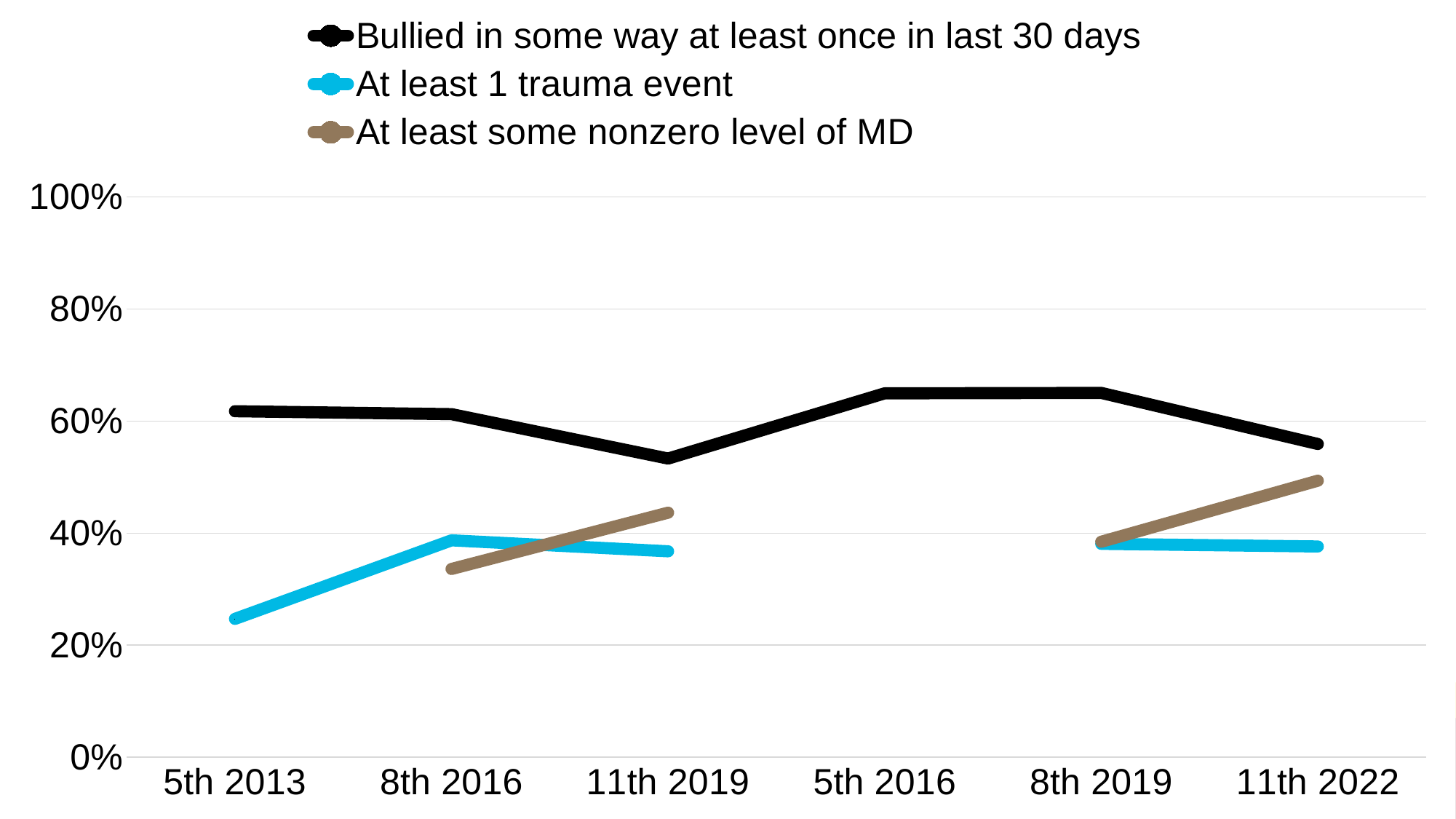
At which category is the 'At least some nonzero level of MD' series highest? 11th 2022 Is the value for 'At least 1 trauma event' at 5th 2013 greater or less than 40%? less How many series does the legend list? 3 What kind of chart is shown on the slide? line chart At which category is the 'At least 1 trauma event' series lowest? 5th 2013 At 11th 2019, which is higher: 'At least 1 trauma event' or 'At least some nonzero level of MD'? At least some nonzero level of MD What colour is the line for 'At least 1 trauma event'? blue Is the value for 'At least some nonzero level of MD' at 11th 2022 greater or less than 40%? greater Is the value for 'Bullied in some way at least once in last 30 days' at 11th 2019 greater or less than 60%? less Does the 'At least 1 trauma event' series rise or fall from 5th 2013 to 8th 2016? rise How many categories are shown on the x axis? 6